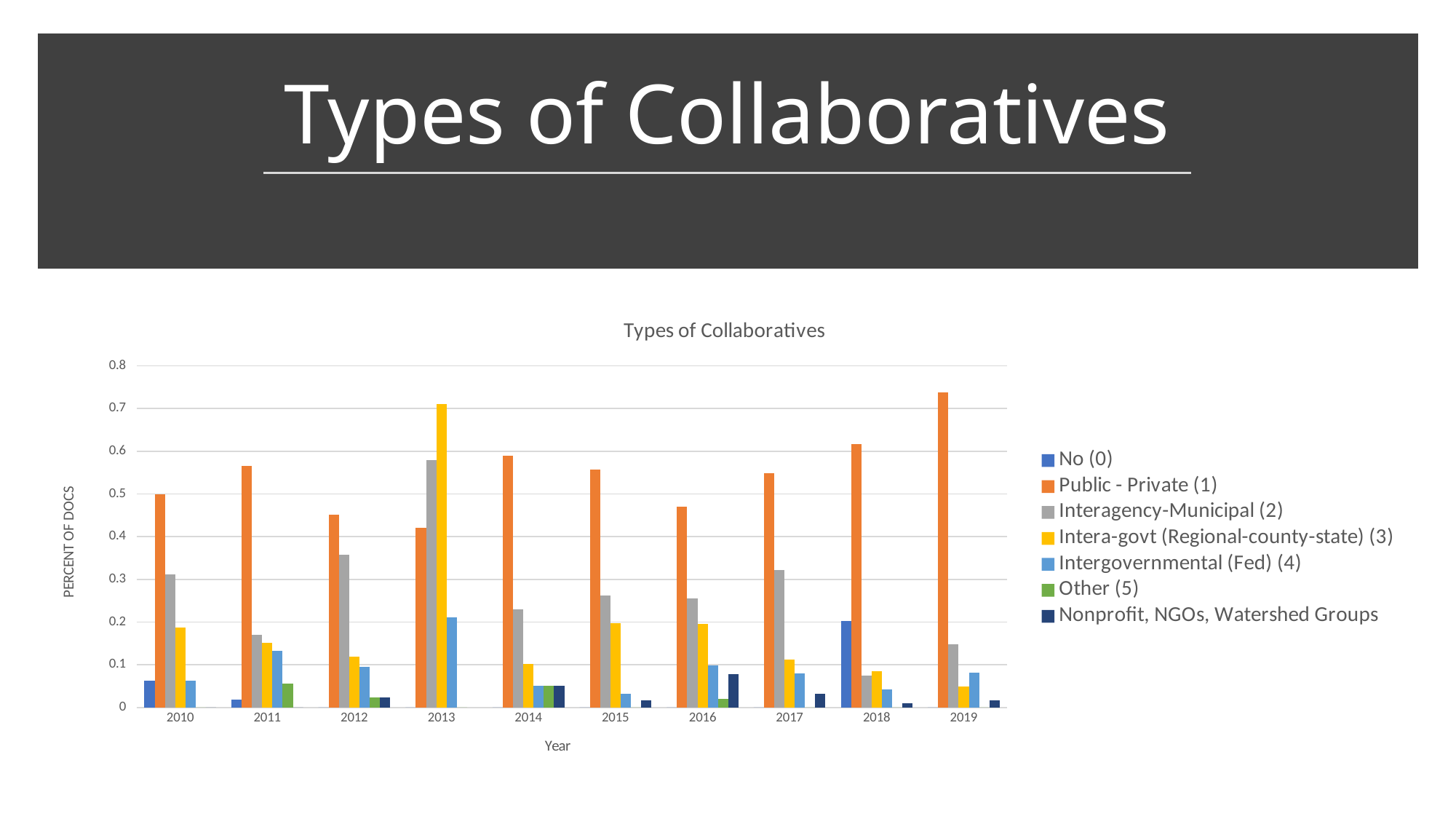
In which year is the Public - Private (1) value highest? 2019 What kind of chart is shown on the slide? bar chart Which series has the highest value in 2013? Intera-govt (Regional-county-state) (3) Is the Intera-govt (Regional-county-state) (3) value for 2013 greater or less than 0.6? greater In 2013, which is larger: Interagency-Municipal (2) or Public - Private (1)? Interagency-Municipal (2) Is the Interagency-Municipal (2) value for 2010 greater or less than 0.4? less In which year is the Public - Private (1) value lowest? 2013 How many years are shown on the x axis? 10 What is the title of the vertical axis? PERCENT OF DOCS How many series does the legend list? 7 Is the Public - Private (1) value for 2019 greater or less than 0.7? greater Which is larger: the Public - Private (1) value for 2018 or for 2017? 2018